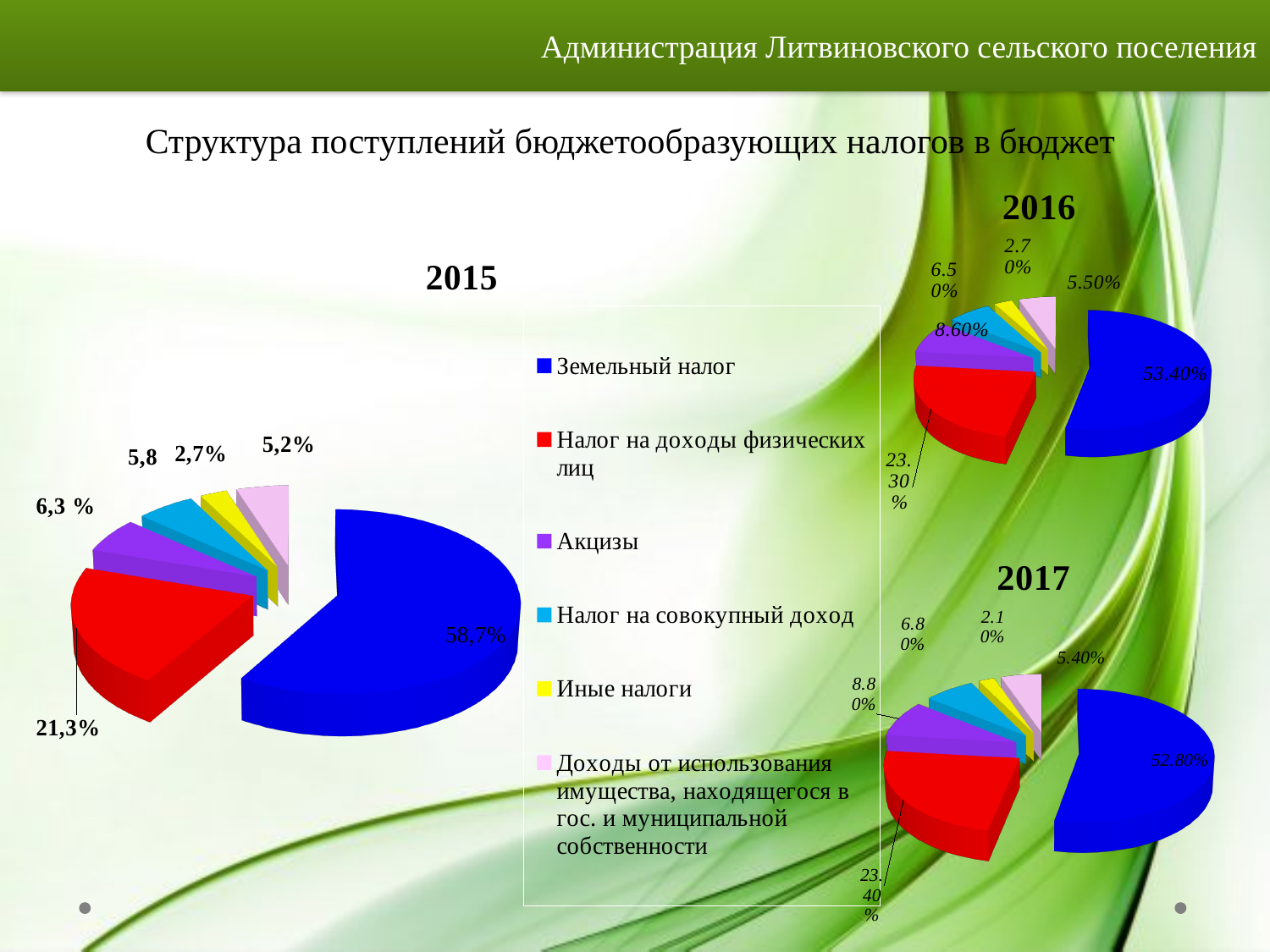
In the 2016 chart, what is the value for Акцизы? 8.60% In the 2016 chart, which category has the largest share? Земельный налог How many entries does the legend list? 6 In the 2015 chart, what is the value for Налог на доходы физических лиц? 21,3% In the 2017 chart, which is larger: Налог на совокупный доход or Доходы от использования имущества? Налог на совокупный доход In the 2015 chart, what share does Земельный налог have? 58,7% In the 2016 chart, what is the difference between the shares of Земельный налог and Налог на доходы физических лиц? 30.10% How many charts are shown on the slide? 3 In the 2017 chart, which category has the smallest share? Иные налоги In the 2017 chart, what is the value for Земельный налог? 52.80% What kind of chart is used for the 2015 data on the slide? pie chart Which colour represents Акцизы in the legend? purple